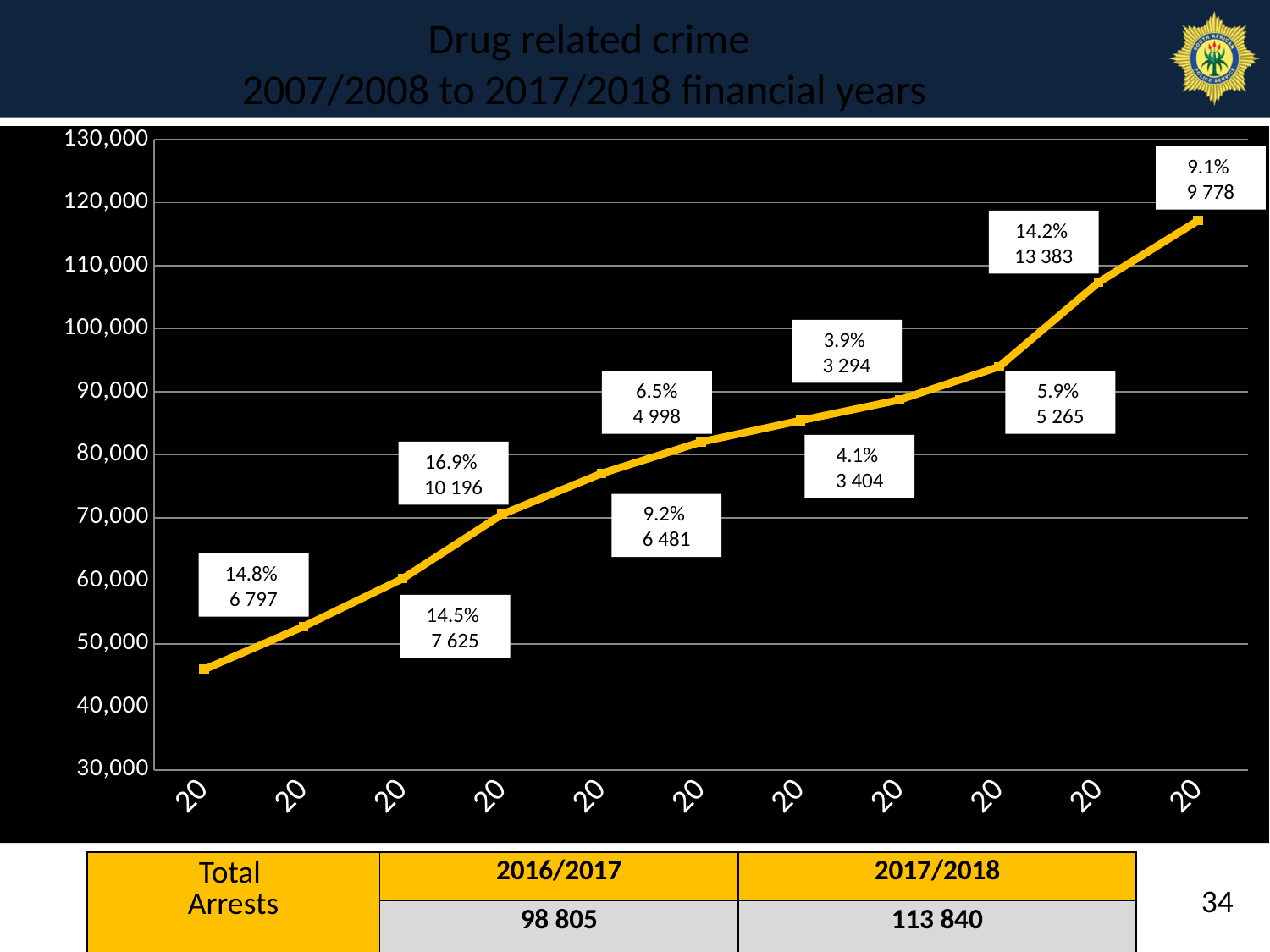
According to the table below the chart, what were the total arrests in 2017/2018? 113 840 Is the value for the first point (2007/2008) greater or less than 50,000? less Is the value for the last point (2017/2018) greater or less than 110,000? greater By how much did total arrests in the table increase from 2016/2017 to 2017/2018? 15 035 Do the values rise or fall from left to right along the x axis? rise What is the largest percentage increase shown in the data labels on the chart? 16.9% What is the title of the slide? Drug related crime 2007/2008 to 2017/2018 financial years How many data points are plotted on the line? 11 According to the table below the chart, what were the total arrests in 2016/2017? 98 805 What is the smallest percentage increase shown in the data labels on the chart? 3.9% What kind of chart is shown on the slide? line chart What number accompanies the 16.9% label on the chart? 10 196